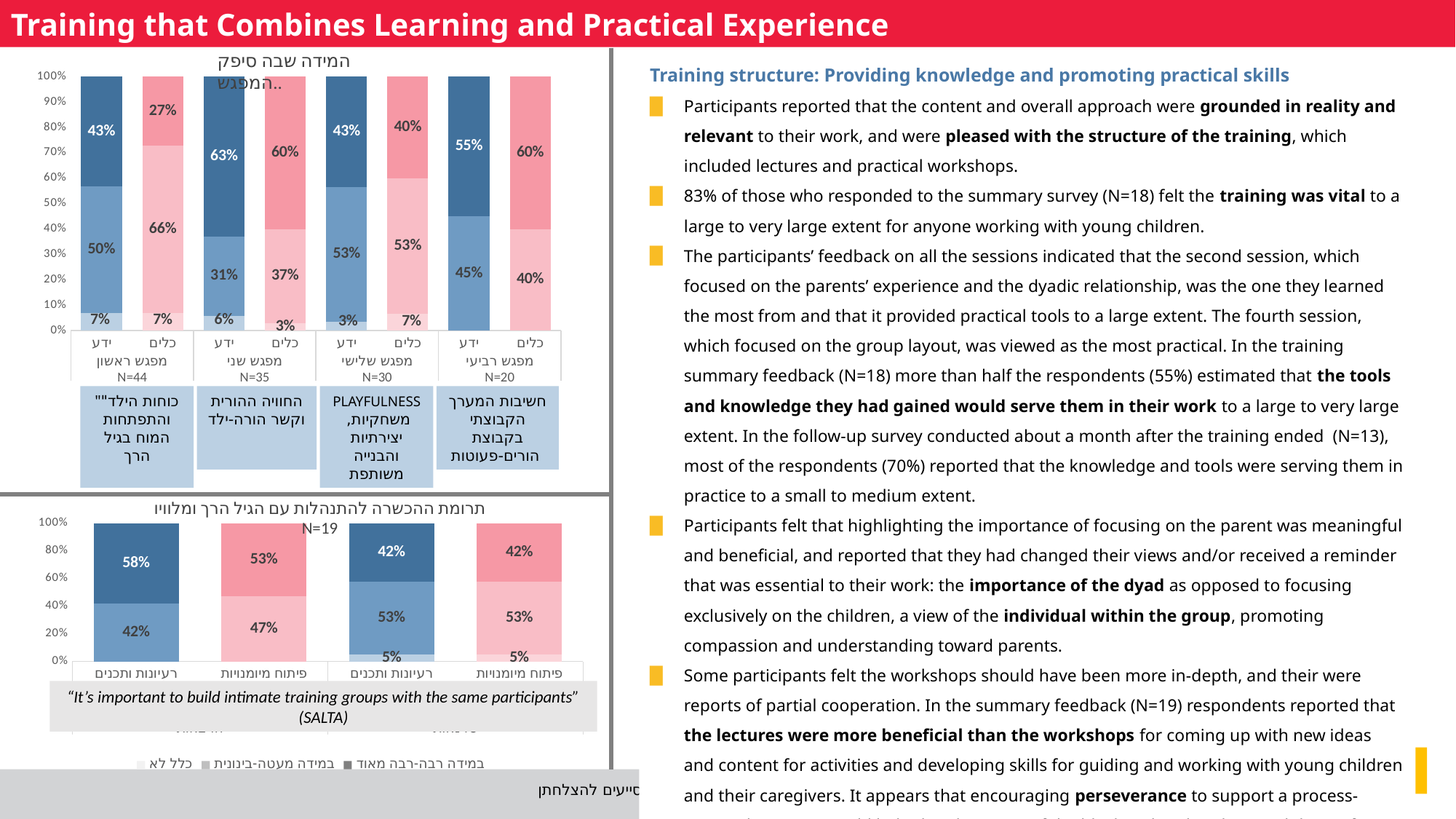
In the top chart, what is the value of the bottom segment of the ידע bar for מפגש שלישי? 3% In the bottom chart (תרומת ההכשרה להתנהלות עם הגיל הרך ומלוויו), what is the value of the top (dark blue) segment of the first רעיונות ותכנים bar? 58% In the top chart, what is the value of the middle (light pink) segment of the כלים bar for מפגש ראשון? 66% In the top chart, which session has the highest top (dark blue) segment in its ידע bar? מפגש שני In the bottom chart, what is the value of the smallest (bottom) segment of the second רעיונות ותכנים bar? 5% In the bottom chart, is the top segment of the first רעיונות ותכנים bar (58%) larger or smaller than the top segment of the first פיתוח מיומנויות bar (53%)? Larger In the top chart, what is the sample size (N) shown for מפגש רביעי? N=20 In the top chart, what is the value of the top (pink) segment of the כלים bar for מפגש רביעי? 60% What type of chart is the top chart on the slide? Stacked bar chart In the top chart, what is the difference between the top segment of the ידע bar (63%) and the top segment of the כלים bar (60%) for מפגש שני? 3% In the top chart (המידה שבה סיפק המפגש), what is the value of the top (dark blue) segment of the ידע bar for מפגש שני? 63% In the bottom chart, what is the value of the bottom segment of the first פיתוח מיומנויות bar? 47%